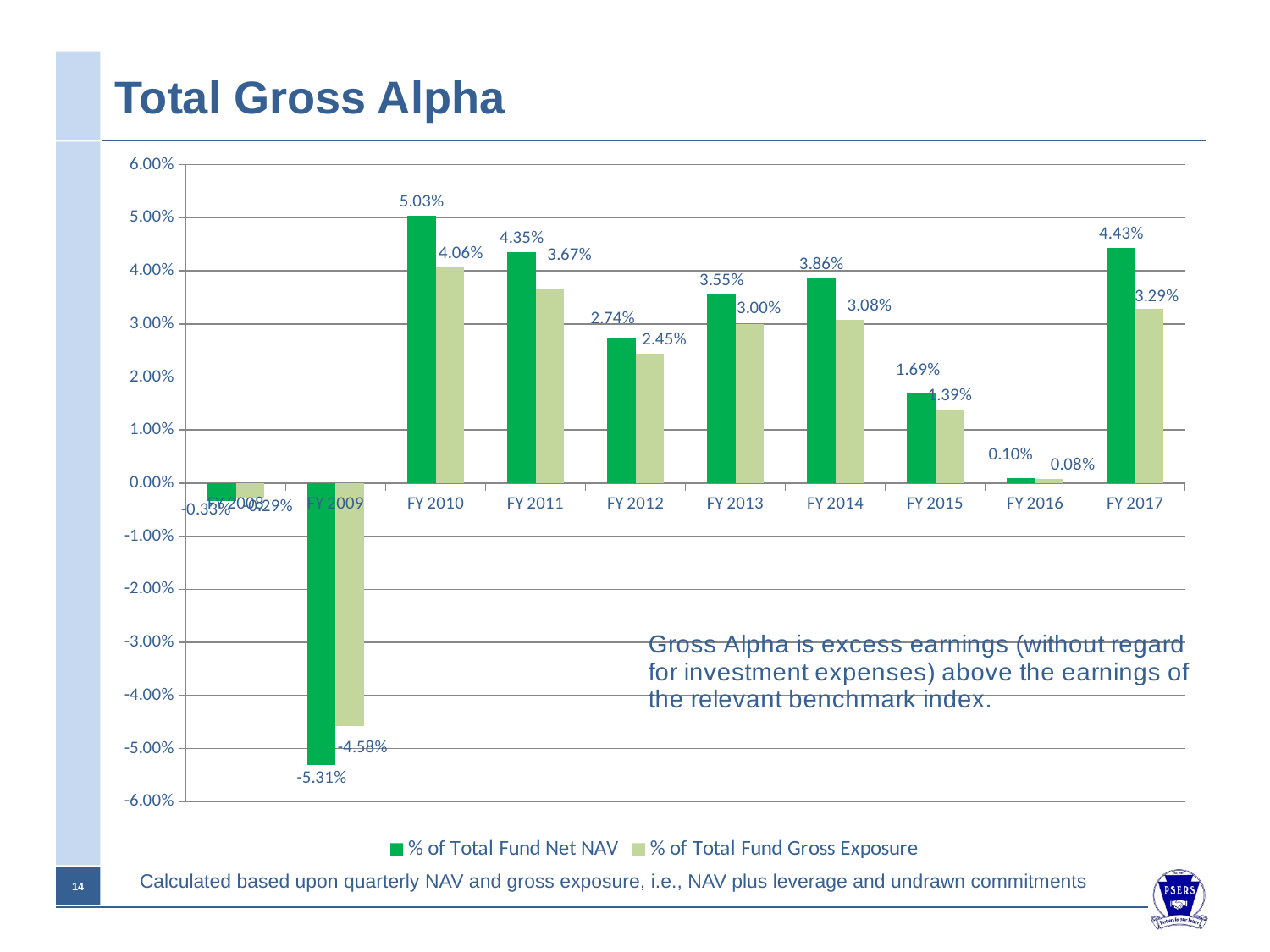
What is the % of Total Fund Gross Exposure value for FY 2009? -4.58% Which fiscal year has the highest % of Total Fund Net NAV value? FY 2010 What is the % of Total Fund Gross Exposure value for FY 2017? 3.29% What is the % of Total Fund Net NAV value for FY 2010? 5.03% Is the % of Total Fund Net NAV value for FY 2012 greater or less than 3.00%? less Which fiscal year has the lowest % of Total Fund Net NAV value? FY 2009 Which is larger: the % of Total Fund Net NAV value for FY 2011 or for FY 2013? FY 2011 How many series does the legend list? 2 Which legend entry is shown in dark green? % of Total Fund Net NAV What is the % of Total Fund Net NAV value for FY 2016? 0.10% What is the difference between the % of Total Fund Net NAV and % of Total Fund Gross Exposure values for FY 2014? 0.78% What kind of chart is shown on the slide? bar chart